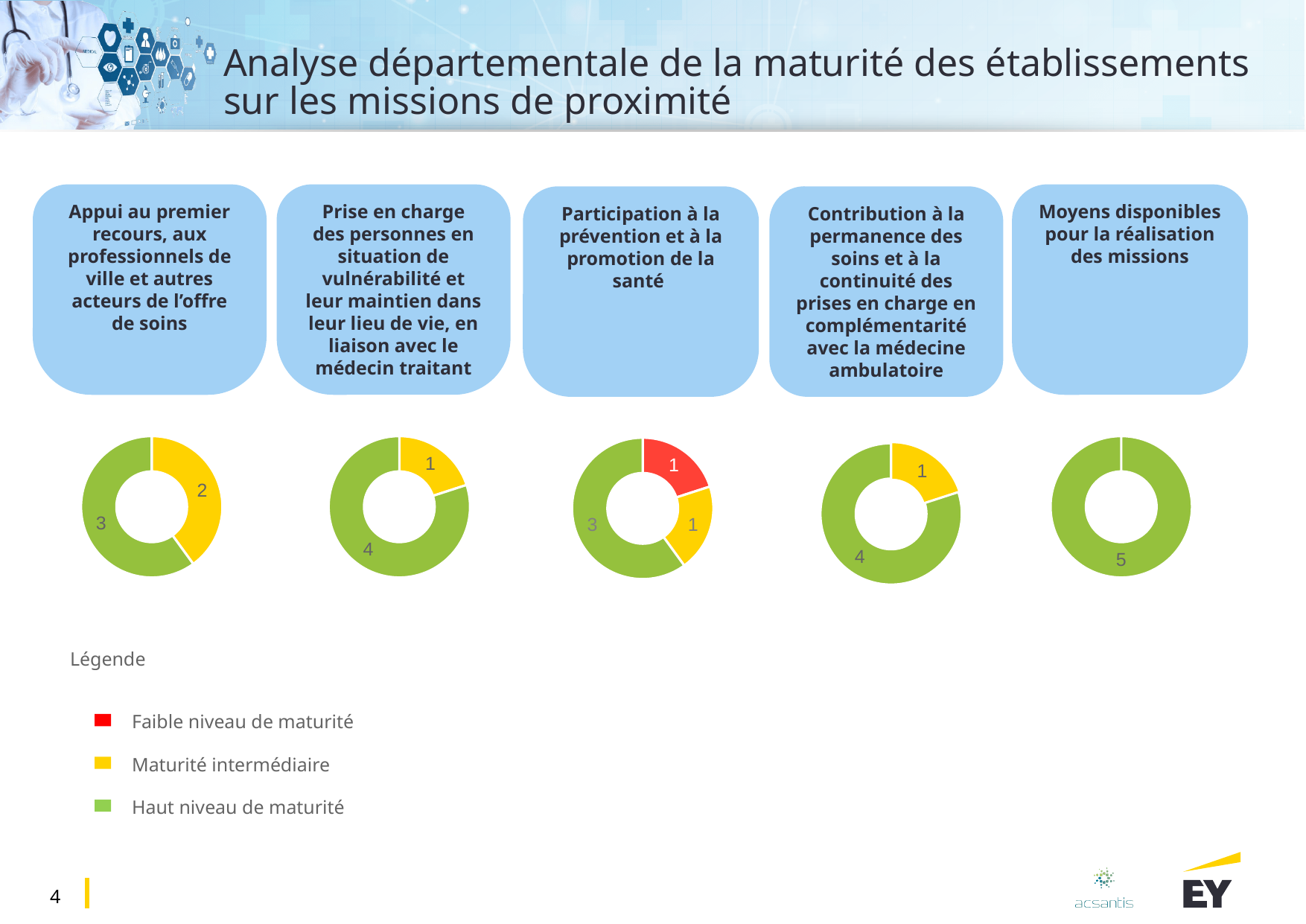
In the fifth donut chart from the left (Moyens disponibles pour la réalisation des missions), what share of the donut does the green slice represent? 100% In the first donut chart from the left (Appui au premier recours), what is the value of the yellow 'Maturité intermédiaire' slice? 2 In the first donut chart from the left (Appui au premier recours), what is the difference between the green slice and the yellow slice? 1 According to the legend, what does the red colour represent? Faible niveau de maturité In the first donut chart from the left (Appui au premier recours), what is the value of the green 'Haut niveau de maturité' slice? 3 In the third donut chart from the left (Participation à la prévention et à la promotion de la santé), what is the total of all slices? 5 In the third donut chart from the left (Participation à la prévention et à la promotion de la santé), what is the value of the red 'Faible niveau de maturité' slice? 1 In the third donut chart from the left (Participation à la prévention et à la promotion de la santé), how many slices does the donut have? 3 In the second donut chart from the left (Prise en charge des personnes en situation de vulnérabilité), what is the value of the green slice? 4 In the fourth donut chart from the left (Contribution à la permanence des soins), which slice is larger, the green one or the yellow one? green How many donut charts are shown on the slide? 5 In the fifth donut chart from the left (Moyens disponibles pour la réalisation des missions), what is the value of the green slice? 5